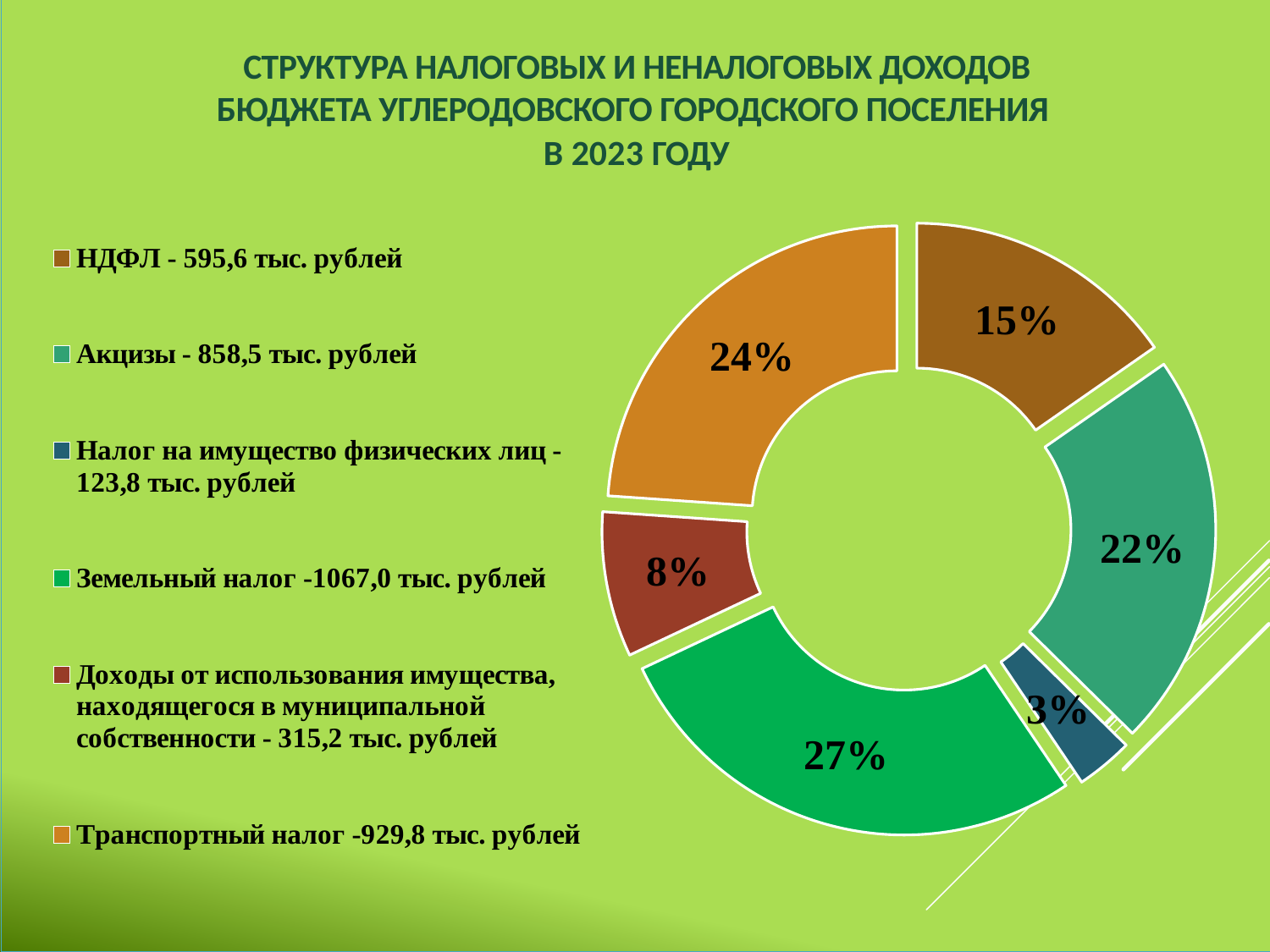
According to the legend, what is the amount for Доходы от использования имущества, находящегося в муниципальной собственности? 315,2 тыс. рублей What percentage is shown for Налог на имущество физических лиц? 3% What percentage is shown for Транспортный налог? 24% According to the legend, what is the amount for Акцизы? 858,5 тыс. рублей Which category has the smallest share of the chart? Налог на имущество физических лиц What percentage is shown for Акцизы? 22% What kind of chart is shown on the slide? Doughnut (pie) chart How many categories does the chart show? 6 Which has a larger share, Транспортный налог or Акцизы? Транспортный налог Which category has the largest share of the chart? Земельный налог What share of the chart does Земельный налог account for? 27% What is the difference in percentage points between the shares of Земельный налог and НДФЛ? 12